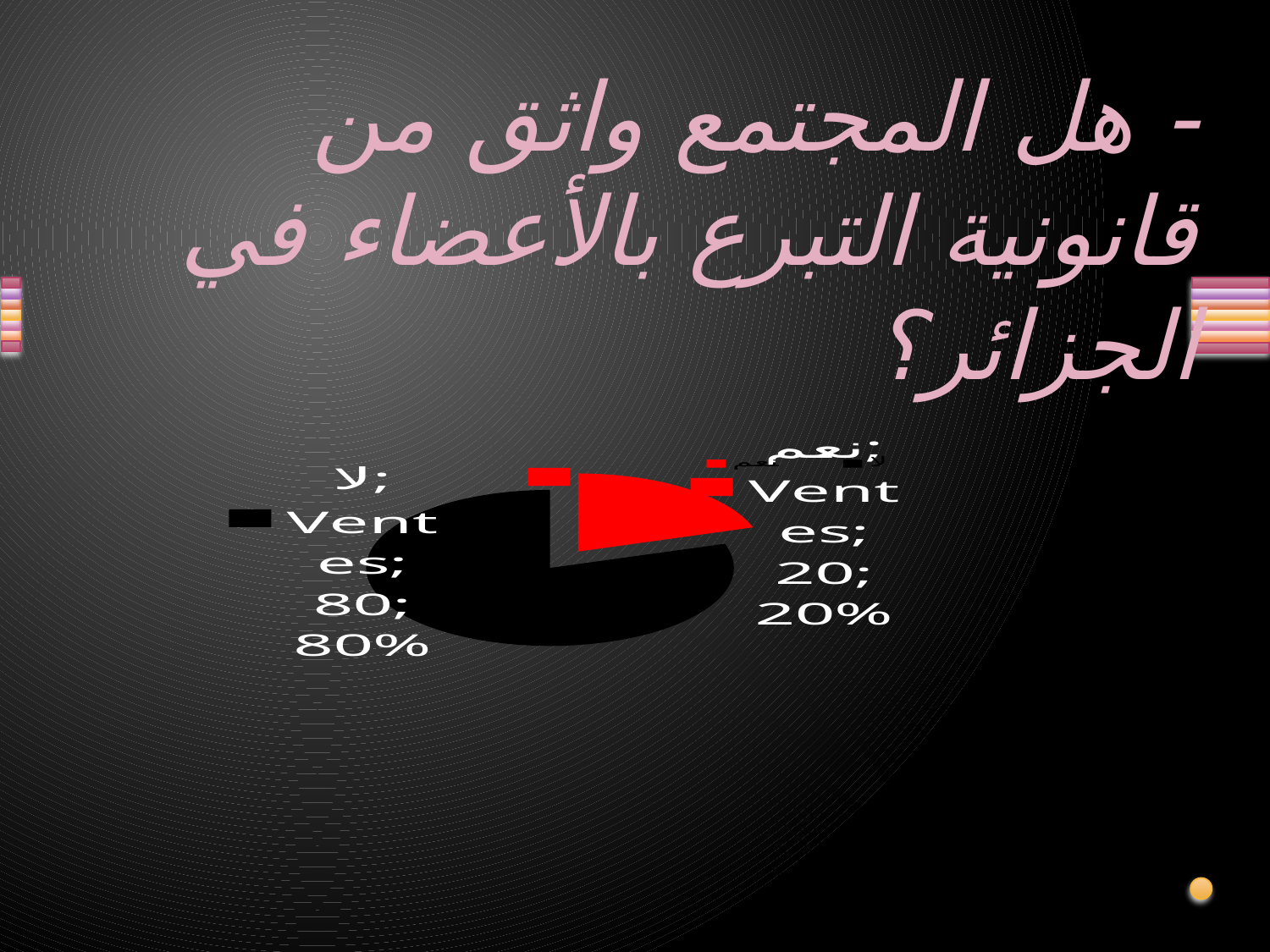
Which is larger, the "لا" slice or the "نعم" slice? لا What is the value shown for the "نعم" slice? 20 What colour is the "نعم" slice? red Which slice is the smallest in the pie chart? نعم What is the value shown for the "لا" slice? 80 What percentage of the pie does the "لا" slice represent? 80% Which slice is the largest in the pie chart? لا What colour is the "لا" slice? black What is the difference between the values for "لا" and "نعم"? 60 What percentage of the pie does the "نعم" slice represent? 20% What kind of chart is shown on the slide? pie chart How many slices does the pie chart have? 2